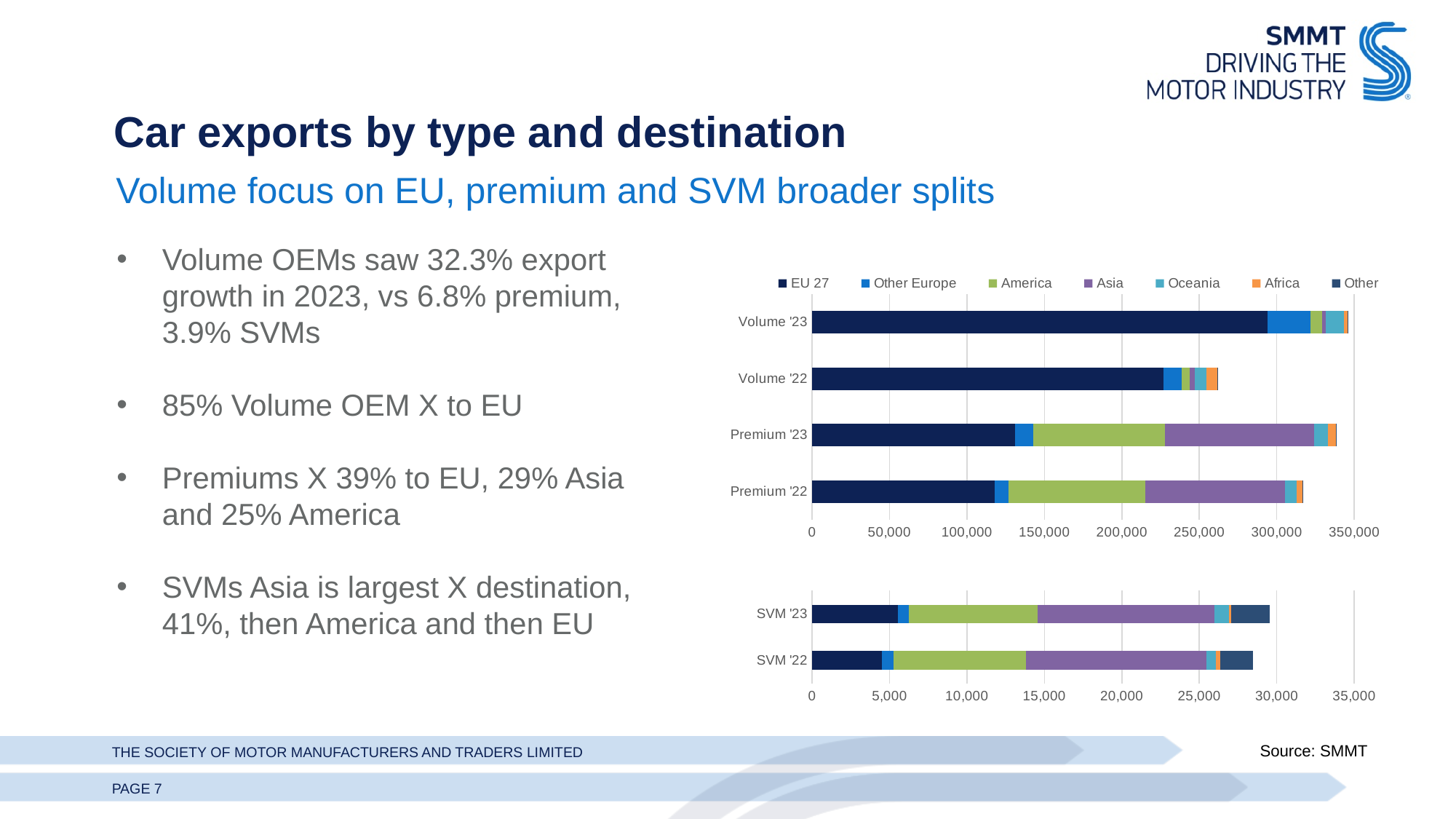
In the top chart, is the total bar for Volume '23 longer or shorter than the total bar for Volume '22? longer In the bottom chart, is the EU 27 value for SVM '22 greater or less than 5,000? less How many series does the legend of the top chart list? 7 In the top chart, is the EU 27 value for Volume '23 greater or less than 250,000? greater In the top chart, which category has the shortest total bar? Volume '22 How many categories are plotted in the bottom chart (SVM)? 2 In the top chart, is the total for Premium '23 greater or less than 300,000? greater What kind of chart is the top chart on the slide? bar chart In the top chart, is the total bar for Premium '23 longer or shorter than the total bar for Premium '22? longer How many categories are plotted in the top chart (Volume and Premium)? 4 In the top chart, which series is shown in green in the legend? America